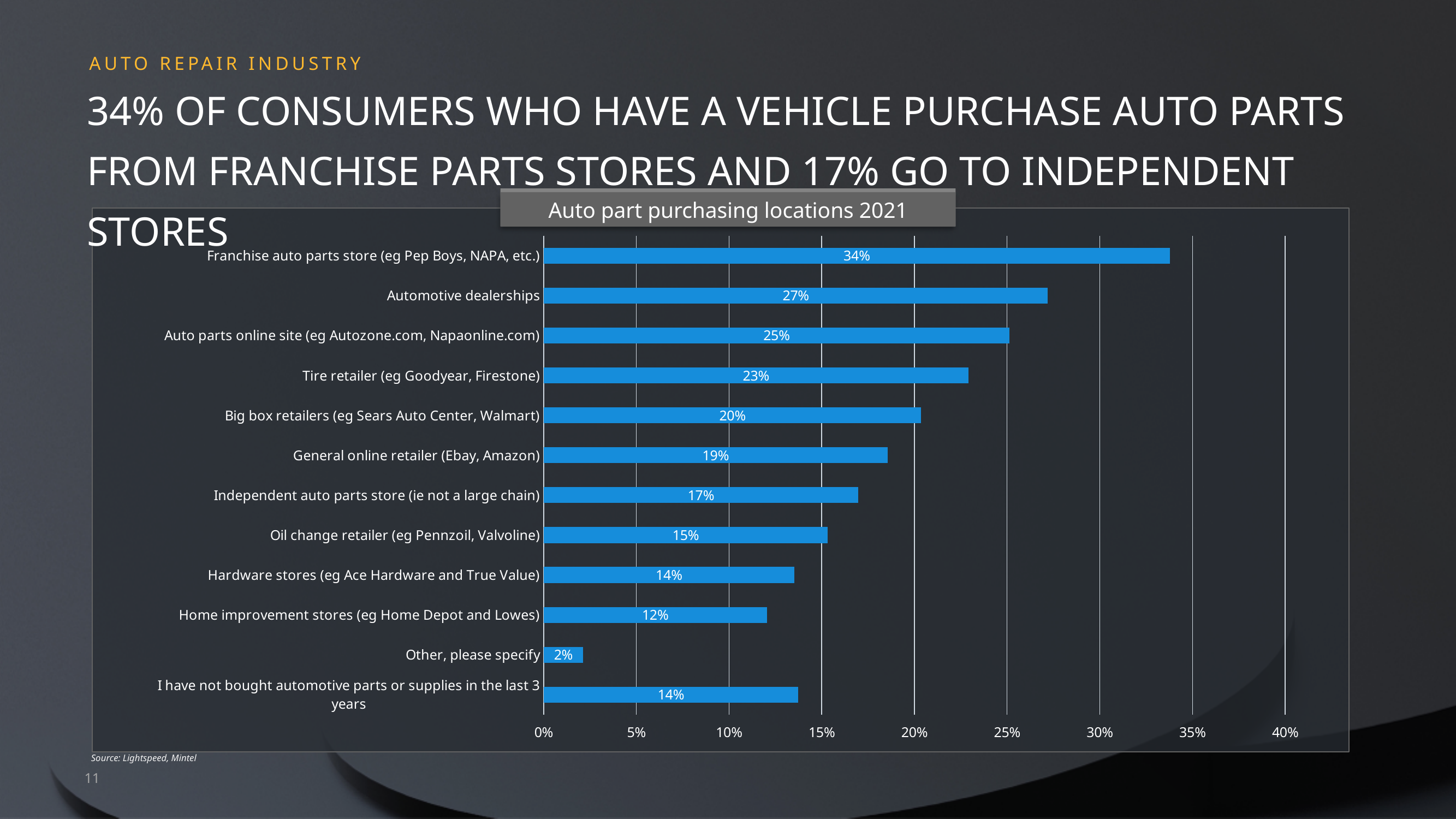
What is the difference between the values for Oil change retailer and Hardware stores? 1% Which category has the highest value in the chart? Franchise auto parts store (eg Pep Boys, NAPA, etc.) What is the title of the chart? Auto part purchasing locations 2021 Which category has the lowest value in the chart? Other, please specify Which is larger: the value for Big box retailers or the value for General online retailer? Big box retailers (eg Sears Auto Center, Walmart) What percentage of consumers purchase auto parts from automotive dealerships? 27% What kind of chart is shown on the slide? Bar chart How many categories are shown in the chart? 12 Is the value for Auto parts online site greater or less than 20%? greater What is the value for Tire retailer (eg Goodyear, Firestone)? 23% What is the difference between the values for Franchise auto parts store and Independent auto parts store? 17% What is the value for Home improvement stores (eg Home Depot and Lowes)? 12%